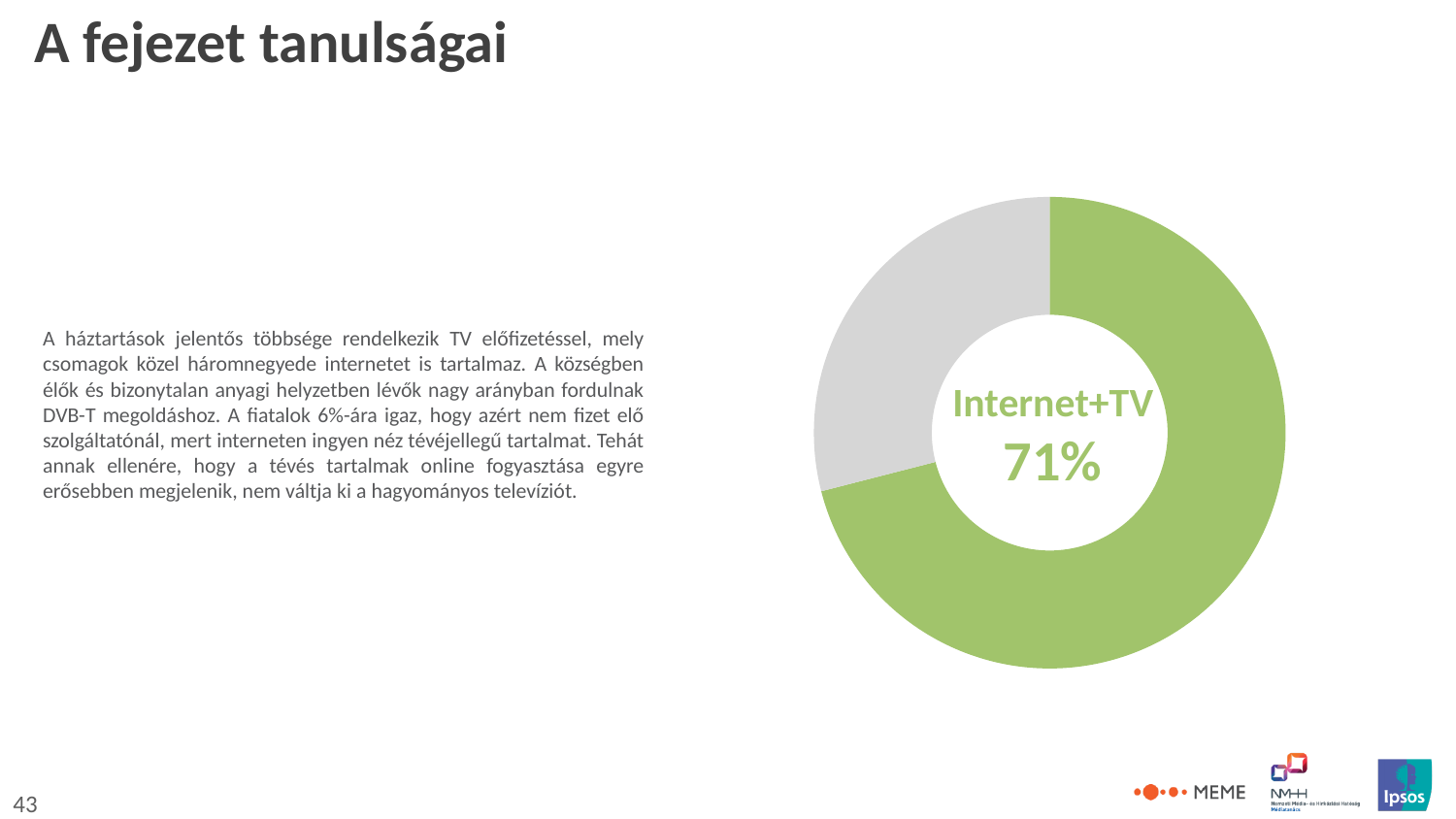
How many slices does the pie chart have? 2 What share of the pie does the Internet+TV slice represent? 71% What label is printed in the centre of the donut chart? Internet+TV 71% Which slice of the chart is the largest? Internet+TV What colour is the Internet+TV slice of the chart? Green Which slice is larger, the green slice or the grey slice? The green slice What kind of chart is shown on the slide? Pie chart (donut) What percentage is shown for Internet+TV in the chart? 71%